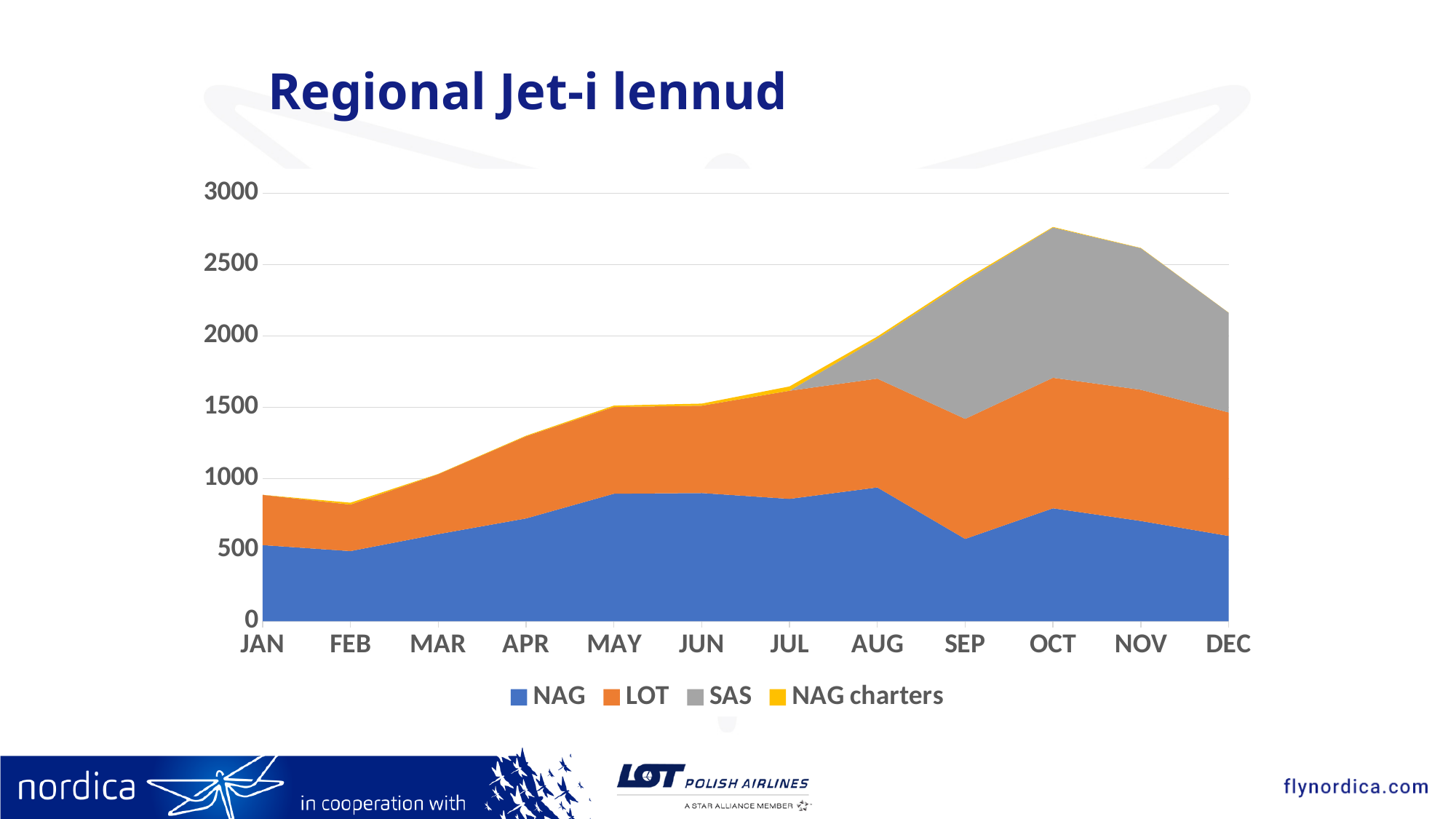
Is the NAG value for MAY greater or less than 500? greater How many series does the legend list? 4 Is the total stacked value for OCT greater or less than 2500? greater How many months are shown along the x axis? 12 What is the title of the chart? Regional Jet-i lennud Is the total stacked value for JAN greater or less than 1000? less What kind of chart is shown on the slide? Stacked area chart Which series is shown in grey? SAS Does the total stacked value rise or fall from OCT to DEC? Fall Which month has the larger total stacked value, JAN or OCT? OCT In which month is the total stacked value highest? OCT